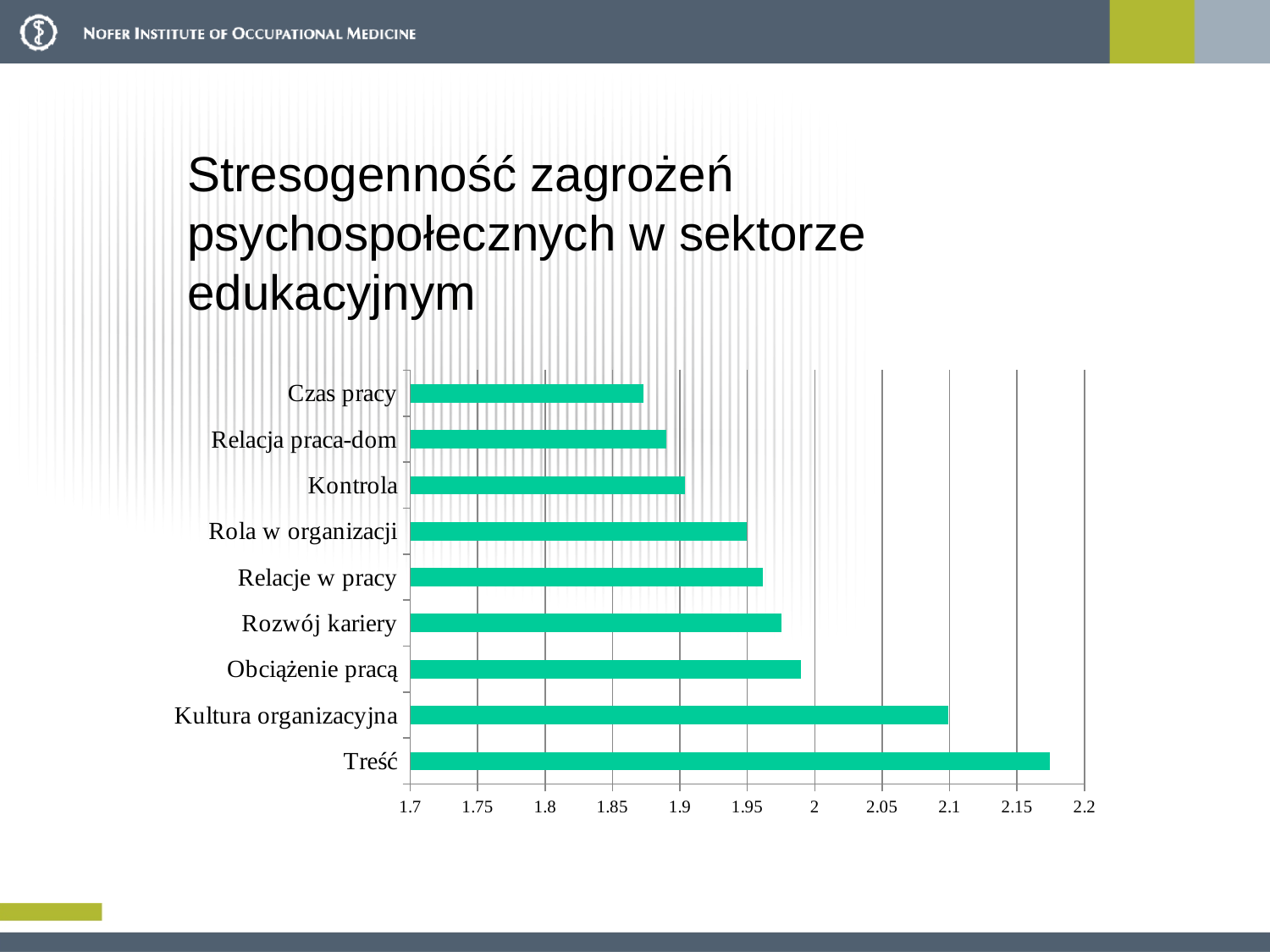
Which category has the lowest value in the chart? Czas pracy Which category has the highest value in the chart? Treść Which has the larger value, Czas pracy or Obciążenie pracą? Obciążenie pracą Is the value for Treść greater or less than 2.15? greater How many categories are plotted in the chart? 9 Which has the larger value, Treść or Kultura organizacyjna? Treść Is the value for Kultura organizacyjna greater or less than 2.05? greater Is the value for Czas pracy greater or less than 1.9? less Do the bar values increase or decrease going from the top category to the bottom category? increase What is the title of the slide containing the chart? Stresogenność zagrożeń psychospołecznych w sektorze edukacyjnym What kind of chart is shown on the slide? bar chart